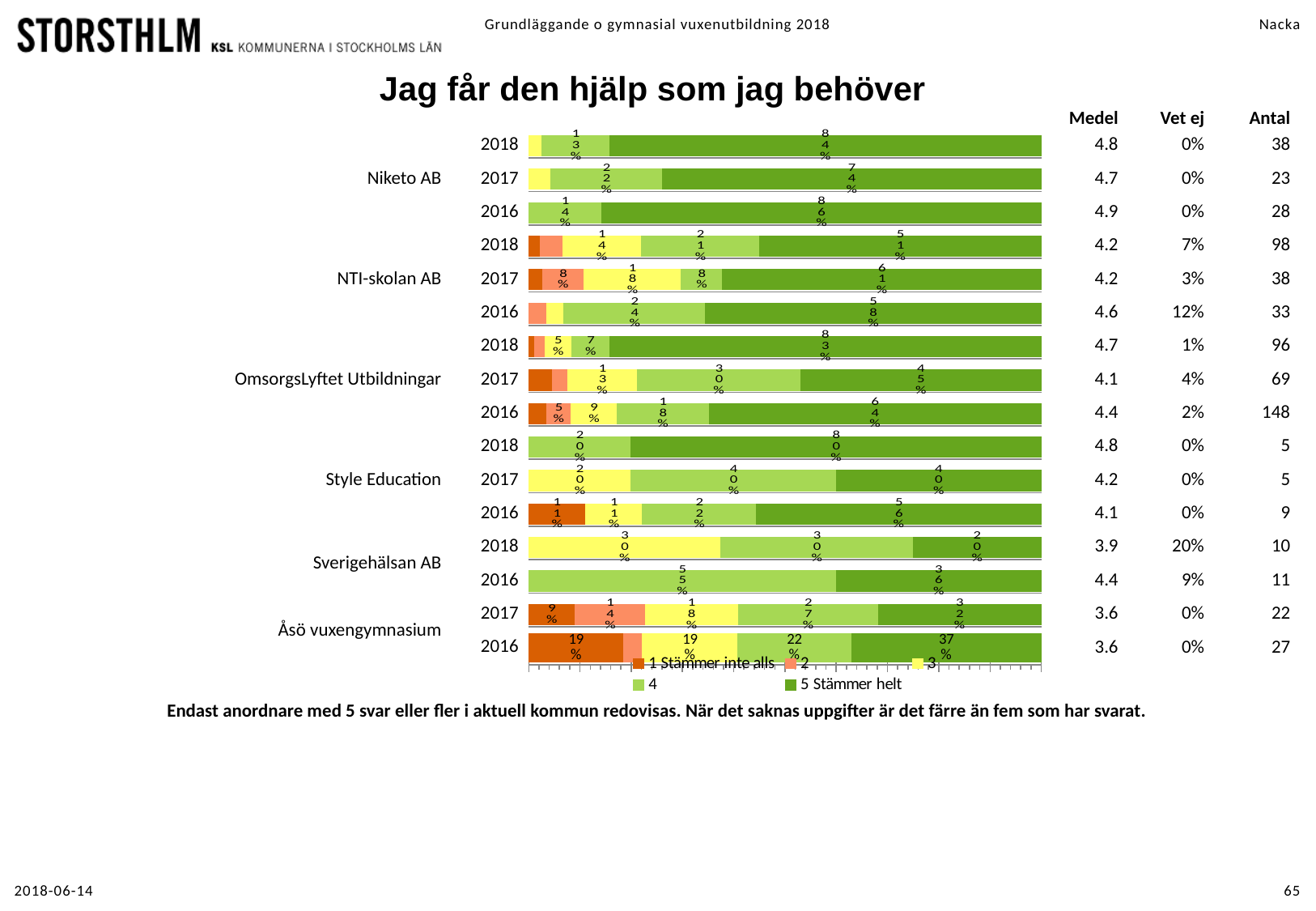
How many bars (provider-year rows) are plotted in the chart? 16 How many series does the legend list? 5 What is the value of the '5 Stämmer helt' segment for Style Education in 2018? 80% Which is larger for Åsö vuxengymnasium in 2016: the '4' segment or the '5 Stämmer helt' segment? 5 Stämmer helt What is the label of the first legend entry? 1 Stämmer inte alls What kind of chart is shown on the slide? Stacked bar chart What is the value of the '4' segment for Sverigehälsan AB in 2016? 55% What is the difference between the '5 Stämmer helt' segment for Niketo AB in 2016 (86%) and in 2017 (74%)? 12% What is the value of the '1 Stämmer inte alls' segment for Åsö vuxengymnasium in 2016? 19% What is the value of the '5 Stämmer helt' segment for OmsorgsLyftet Utbildningar in 2017? 45% What is the title of the chart? Jag får den hjälp som jag behöver What is the value of the '5 Stämmer helt' segment for Niketo AB in 2018? 84%